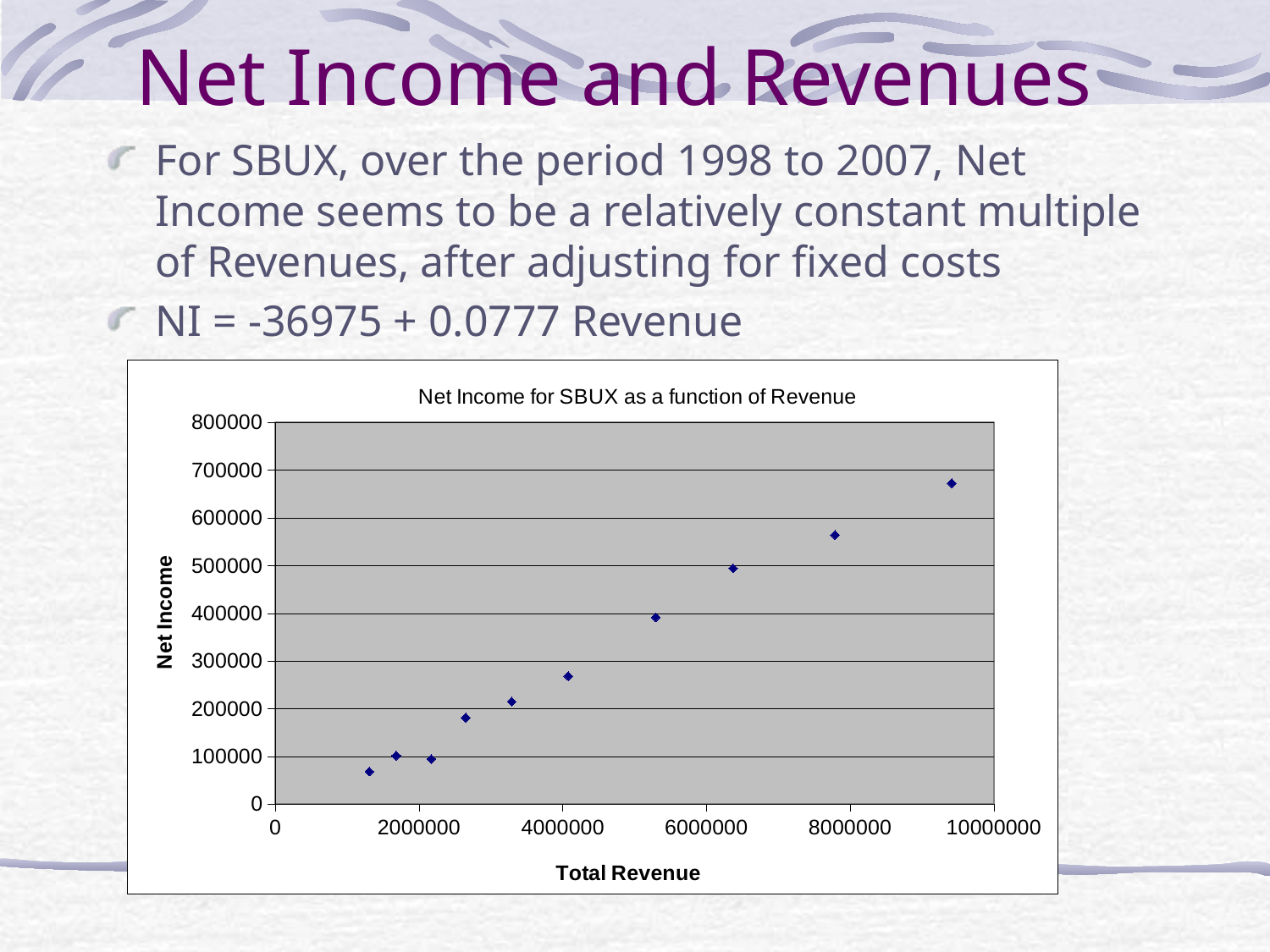
Is the Net Income of the point with the highest Total Revenue greater or less than 600000? greater Is the Net Income of the point with Total Revenue just above 6000000 greater or less than 400000? greater Does Net Income rise or fall as Total Revenue increases along the x axis? rise What kind of chart is shown on the slide? scatter plot How many data points are plotted in the chart? 10 Is the Net Income of the point with Total Revenue just below 8000000 greater or less than 500000? greater What is the label of the horizontal axis of the chart? Total Revenue How many points have a Total Revenue above 6000000? 3 What is the title of the chart? Net Income for SBUX as a function of Revenue